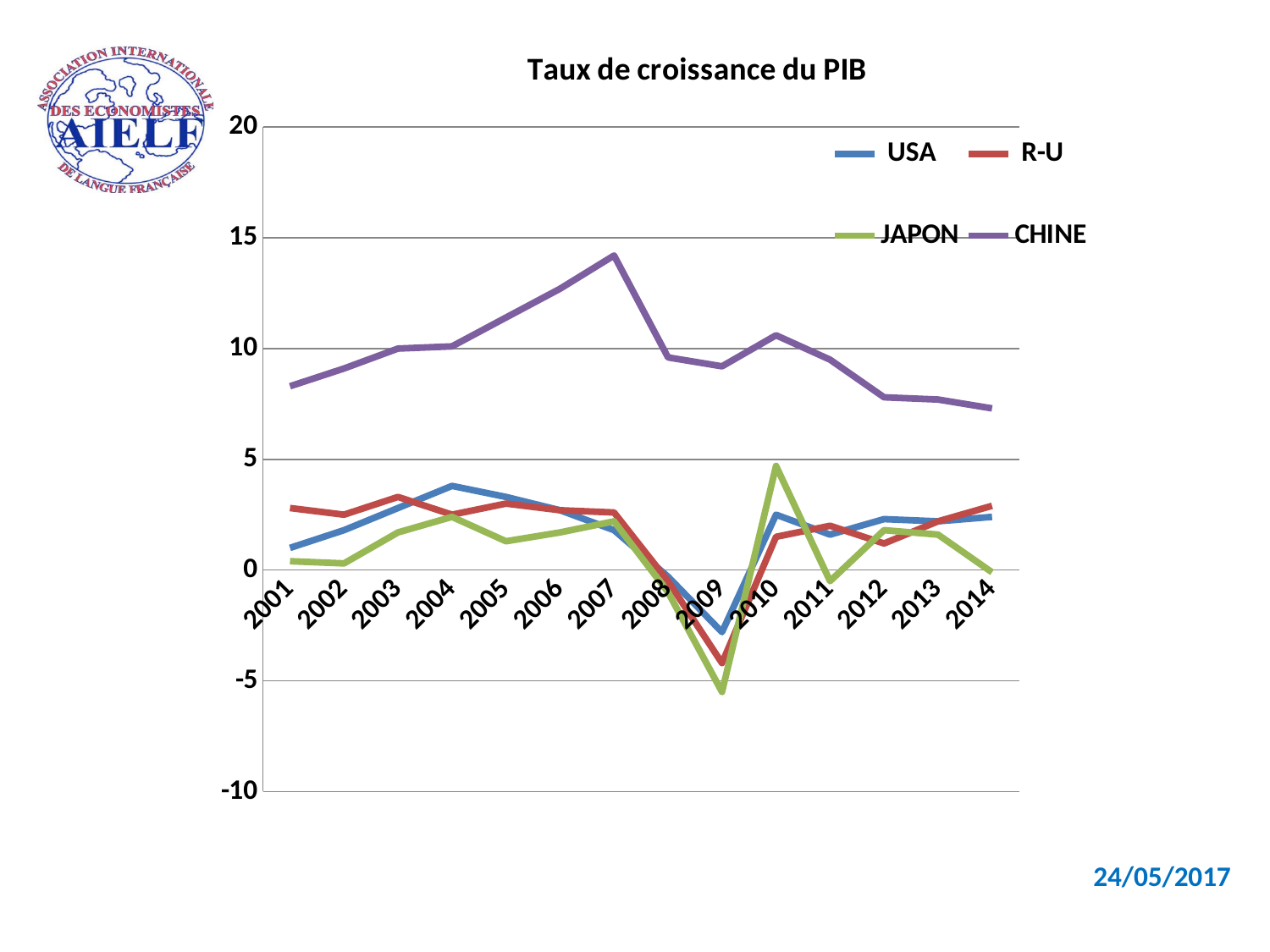
Which series has the highest value in 2007? CHINE Is the value for CHINE in 2007 greater or less than 10? greater Is the value for JAPON in 2009 greater or less than -5? less Which series is drawn in purple? CHINE What is the title of the chart? Taux de croissance du PIB In 2010, which is larger: the value for JAPON or the value for USA? JAPON Is the value for USA in 2004 greater or less than 5? less How many years are plotted along the x axis? 14 Does the CHINE series rise or fall between 2007 and 2014? fall How many series does the legend list? 4 Which series has the lowest value in 2009? JAPON What kind of chart is shown on the slide? line chart